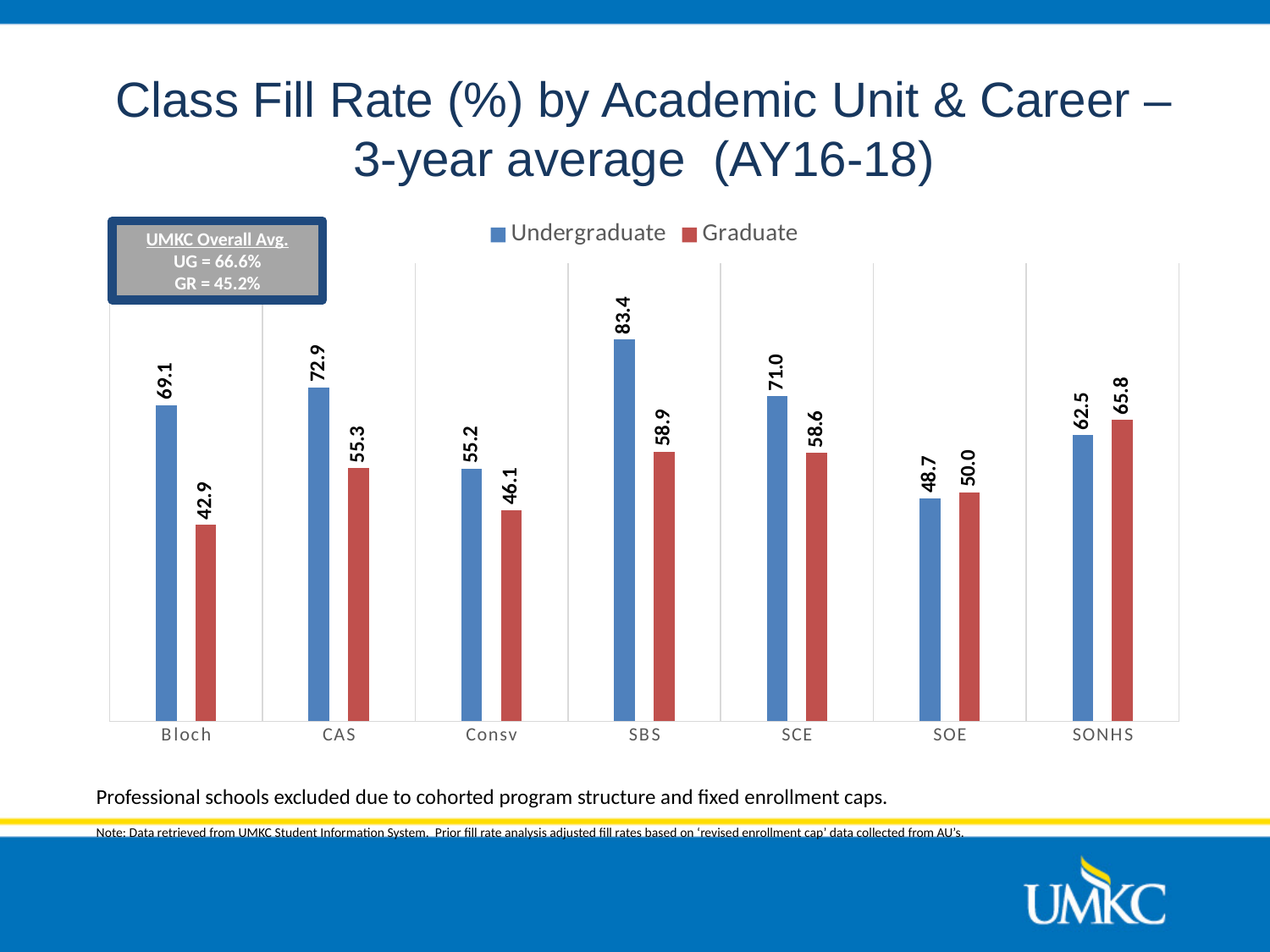
What is the Undergraduate class fill rate for SBS? 83.4 Which is larger for SONHS, the Undergraduate or the Graduate fill rate? Graduate How many academic units are shown on the x axis? 7 How many series does the legend list? 2 What is the Graduate class fill rate for Bloch? 42.9 Which academic unit has the highest Undergraduate fill rate? SBS According to the box on the chart, what is the UMKC overall average Graduate fill rate? 45.2% Which academic unit has the lowest Graduate fill rate? Bloch What is the Graduate value for SONHS? 65.8 What kind of chart is shown on the slide? Bar chart What is the difference between the Undergraduate and Graduate fill rates for Bloch? 26.2 Which academic unit has the lowest Undergraduate fill rate? SOE